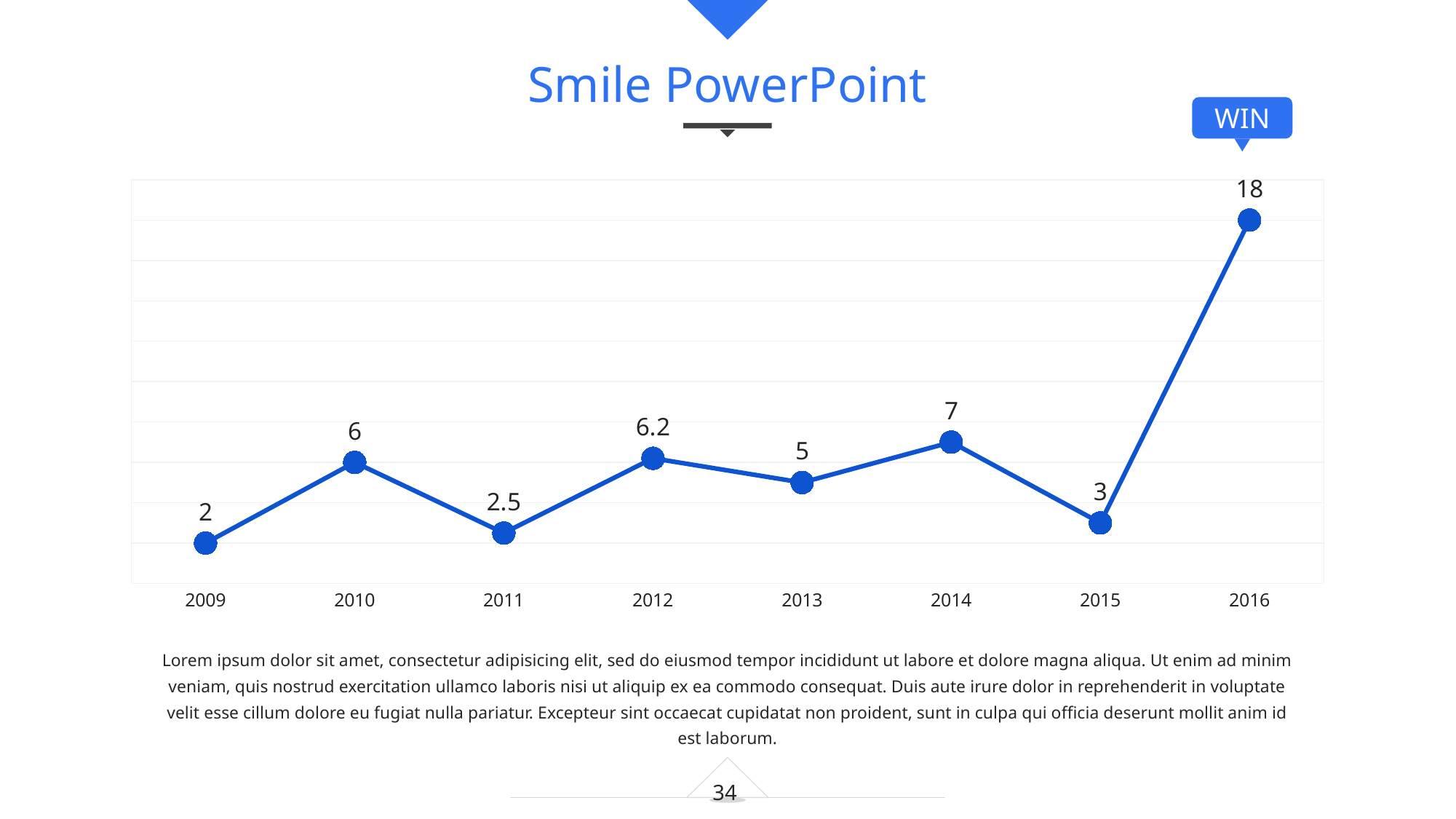
How many years are plotted on the chart? 8 Does the value rise or fall from 2015 to 2016? rise Which year has the highest value? 2016 What is the value for 2012? 6.2 What kind of chart is shown? line chart Which is larger, the value for 2013 or the value for 2014? 2014 Which year has the lowest value? 2009 What is the text in the callout label above the 2016 point? WIN What is the difference between the values for 2016 and 2014? 11 What is the difference between the values for 2010 and 2011? 3.5 What is the value for 2009? 2 What is the value for 2015? 3